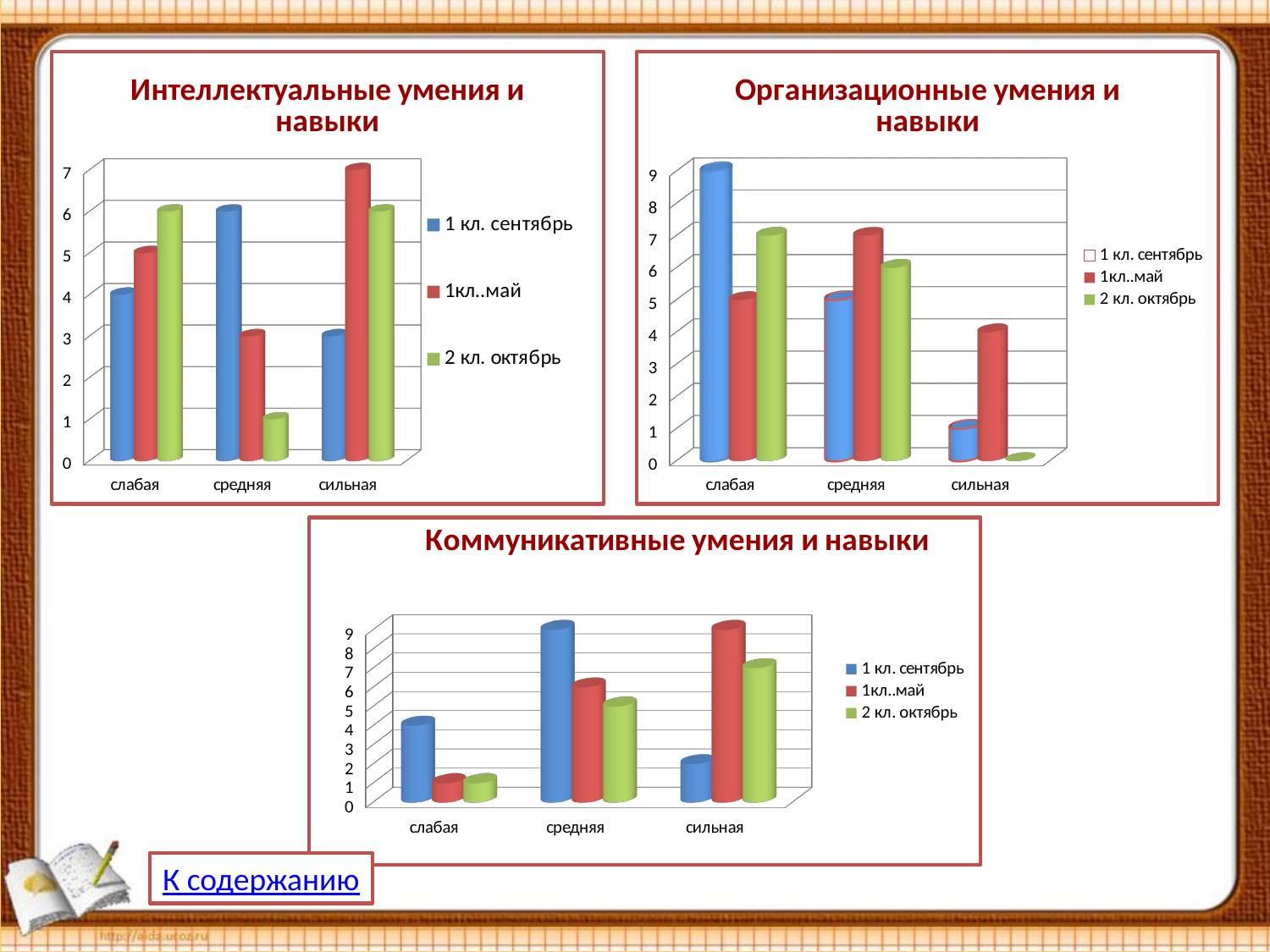
What kind of chart is "Интеллектуальные умения и навыки"? bar chart In "Интеллектуальные умения и навыки", is the value for "1 кл. сентябрь" in the category "средняя" greater or less than 5? greater In "Интеллектуальные умения и навыки", which category has the highest value for the series "1кл..май"? сильная In "Интеллектуальные умения и навыки", which category has the lowest value for the series "2 кл. октябрь"? средняя In "Организационные умения и навыки", is the value for "1кл..май" in the category "сильная" greater or less than 2? greater In "Коммуникативные умения и навыки", is the value for "1 кл. сентябрь" in the category "средняя" greater or less than 7? greater In "Организационные умения и навыки", which category has the highest value for the series "1 кл. сентябрь"? слабая In "Коммуникативные умения и навыки", which category has the lowest value for the series "1 кл. сентябрь"? сильная In "Организационные умения и навыки", for the category "средняя", which is larger: "1кл..май" or "1 кл. сентябрь"? 1кл..май Which colour represents the series "2 кл. октябрь" in "Коммуникативные умения и навыки"? green How many series does the legend of "Организационные умения и навыки" list? 3 How many categories are shown on the x axis of "Коммуникативные умения и навыки"? 3